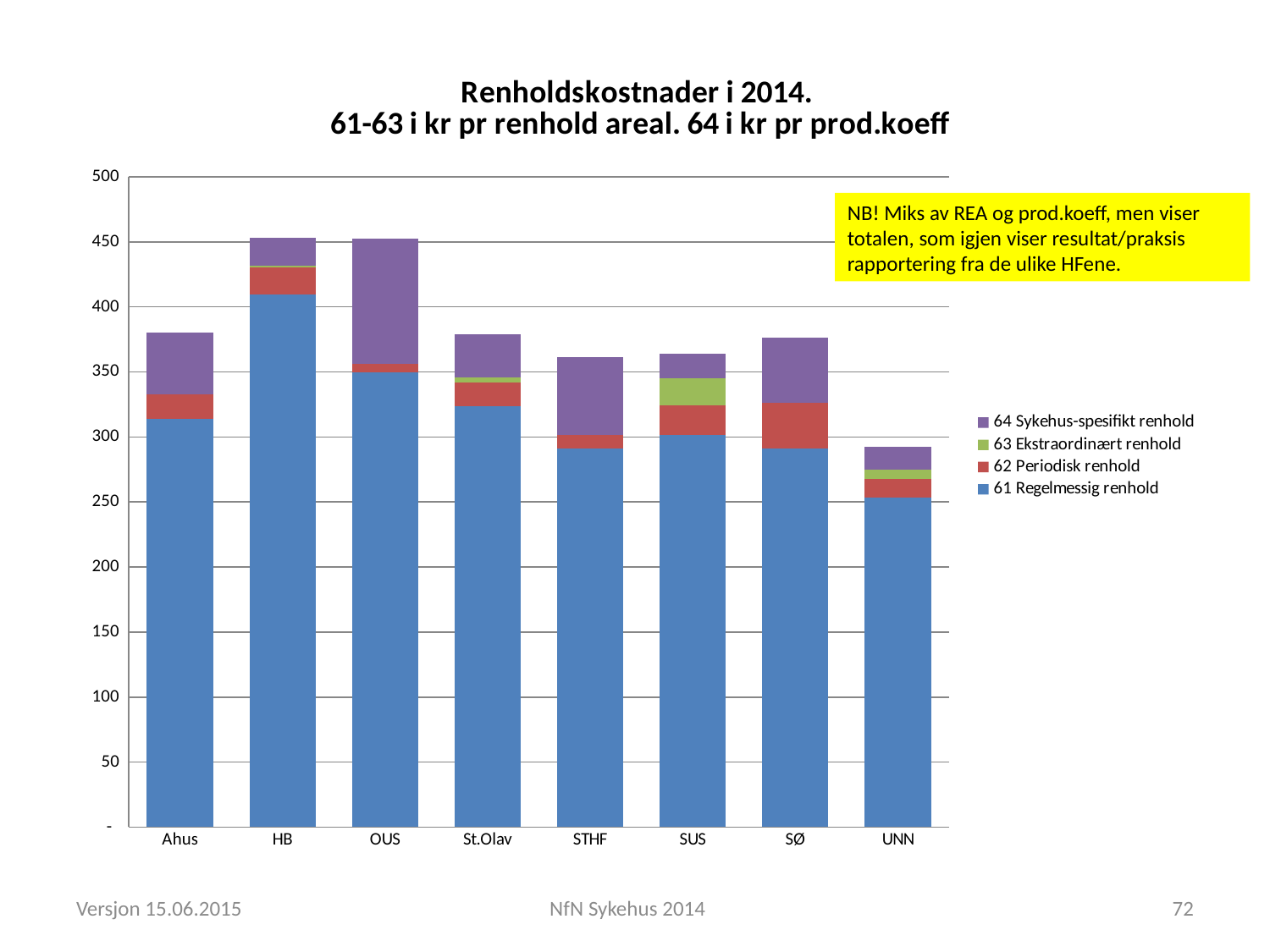
Is the total value for STHF greater or less than 400? less Which series is shown in purple in the legend? 64 Sykehus-spesifikt renhold How many hospitals (categories) are shown on the x axis? 8 Which hospital has the lowest total bar? UNN Is the total value for Ahus greater or less than 350? greater What is the first line of the chart title? Renholdskostnader i 2014. What kind of chart is shown on the slide? Stacked bar chart Which has the larger '61 Regelmessig renhold' segment, HB or OUS? HB How many series does the legend list? 4 Which has the larger total bar, Ahus or UNN? Ahus Is the total value for UNN greater or less than 300? less